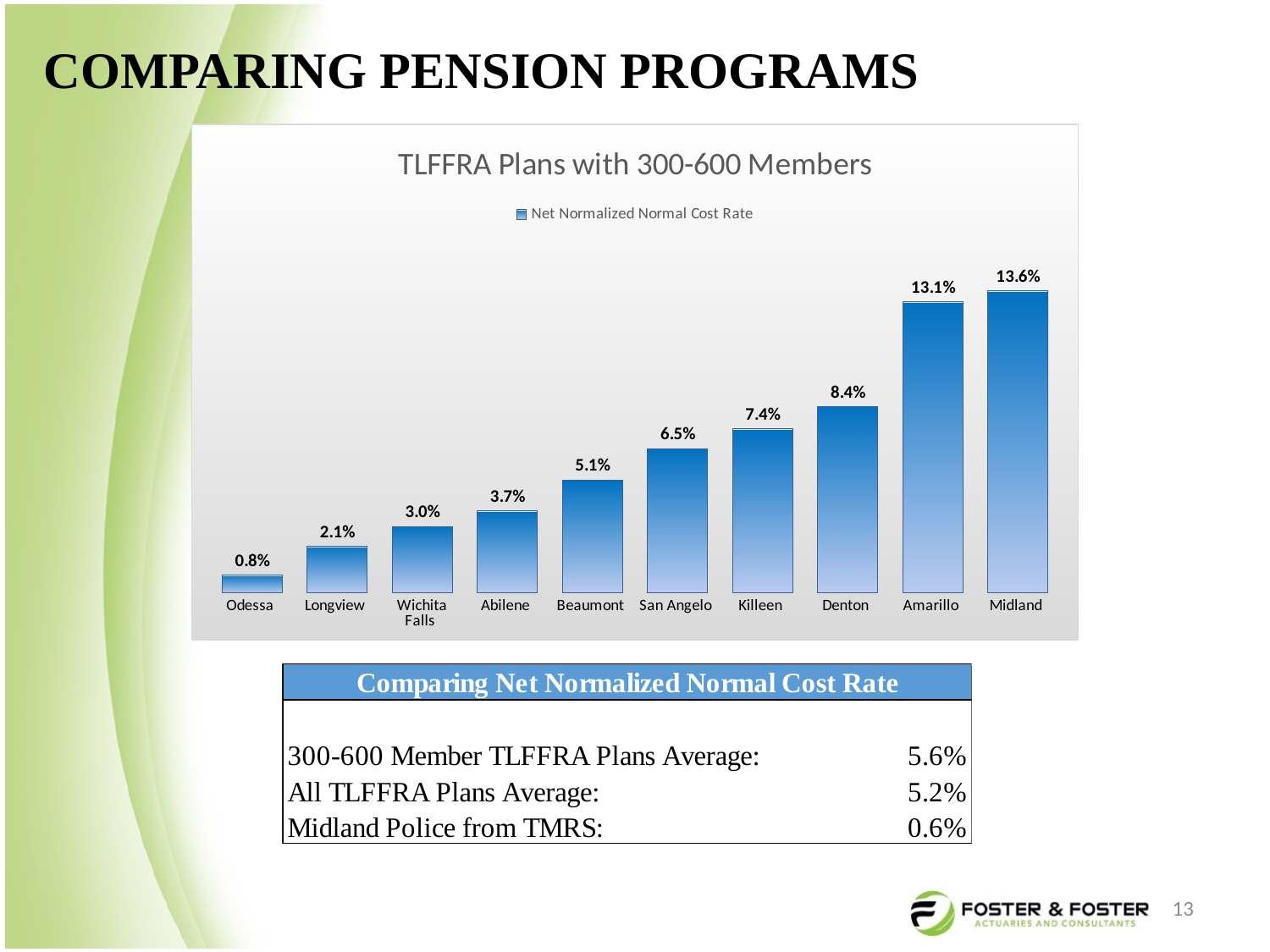
What is the difference between the Net Normalized Normal Cost Rate for Denton and Killeen? 1.0% Which plan has the highest Net Normalized Normal Cost Rate? Midland Which plan has the lowest Net Normalized Normal Cost Rate? Odessa How many series does the legend list? 1 Which has a higher Net Normalized Normal Cost Rate, San Angelo or Abilene? San Angelo What is the difference between the Net Normalized Normal Cost Rate for Midland and Odessa? 12.8% What kind of chart is shown on the slide? Bar chart How many plans are shown in the chart? 10 What is the Net Normalized Normal Cost Rate for Beaumont? 5.1% What is the Net Normalized Normal Cost Rate for Wichita Falls? 3.0% Do the values rise or fall from left to right across the x axis? Rise What is the Net Normalized Normal Cost Rate for Amarillo? 13.1%